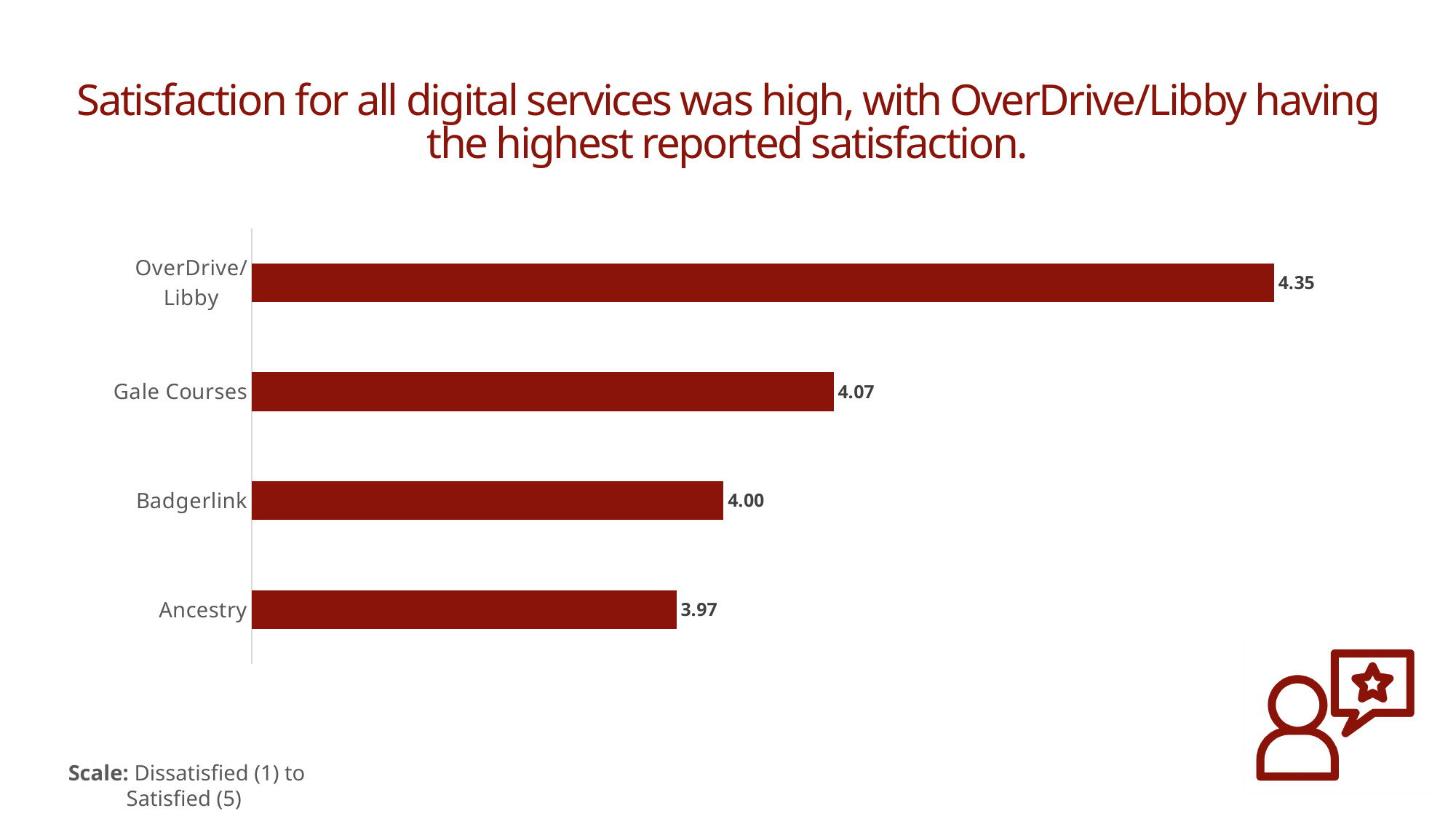
Which digital service has the highest satisfaction value? OverDrive/Libby What scale is used for the satisfaction values, according to the note on the slide? Dissatisfied (1) to Satisfied (5) What is the satisfaction value for OverDrive/Libby? 4.35 What is the difference between the satisfaction values for OverDrive/Libby and Ancestry? 0.38 Which has a higher satisfaction value, Gale Courses or Badgerlink? Gale Courses What kind of chart is shown on the slide? Bar chart Which digital service has the lowest satisfaction value? Ancestry What is the satisfaction value for Badgerlink? 4.00 What is the satisfaction value for Gale Courses? 4.07 What is the difference between the satisfaction values for Gale Courses and Badgerlink? 0.07 How many digital services are shown in the chart? 4 What is the satisfaction value for Ancestry? 3.97